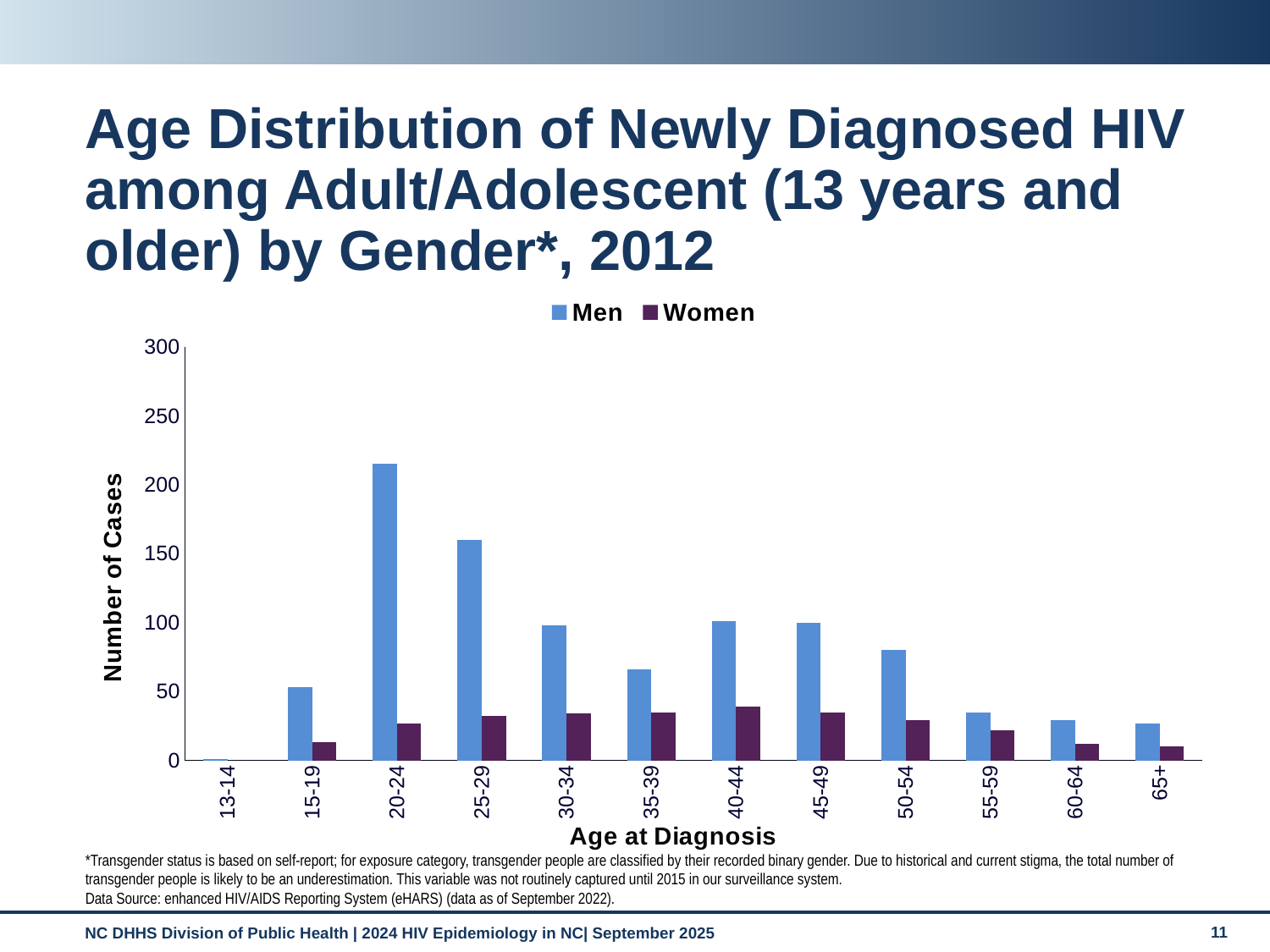
Is the number of cases for women aged 40-44 greater or less than 50? less How many series does the legend list? 2 How many age categories are shown on the x axis? 12 In the 30-34 age group, which series has more cases, Men or Women? Men From the 45-49 age group to the 65+ age group, do the values for men rise or fall? fall Which age group has the lowest number of cases among men? 13-14 What kind of chart is shown on the slide? bar chart Which is larger, the number of cases for men aged 20-24 or men aged 25-29? men aged 20-24 Is the number of cases for men aged 20-24 greater or less than 200? greater Is the number of cases for men aged 25-29 greater or less than 150? greater Which age group has the highest number of cases among men? 20-24